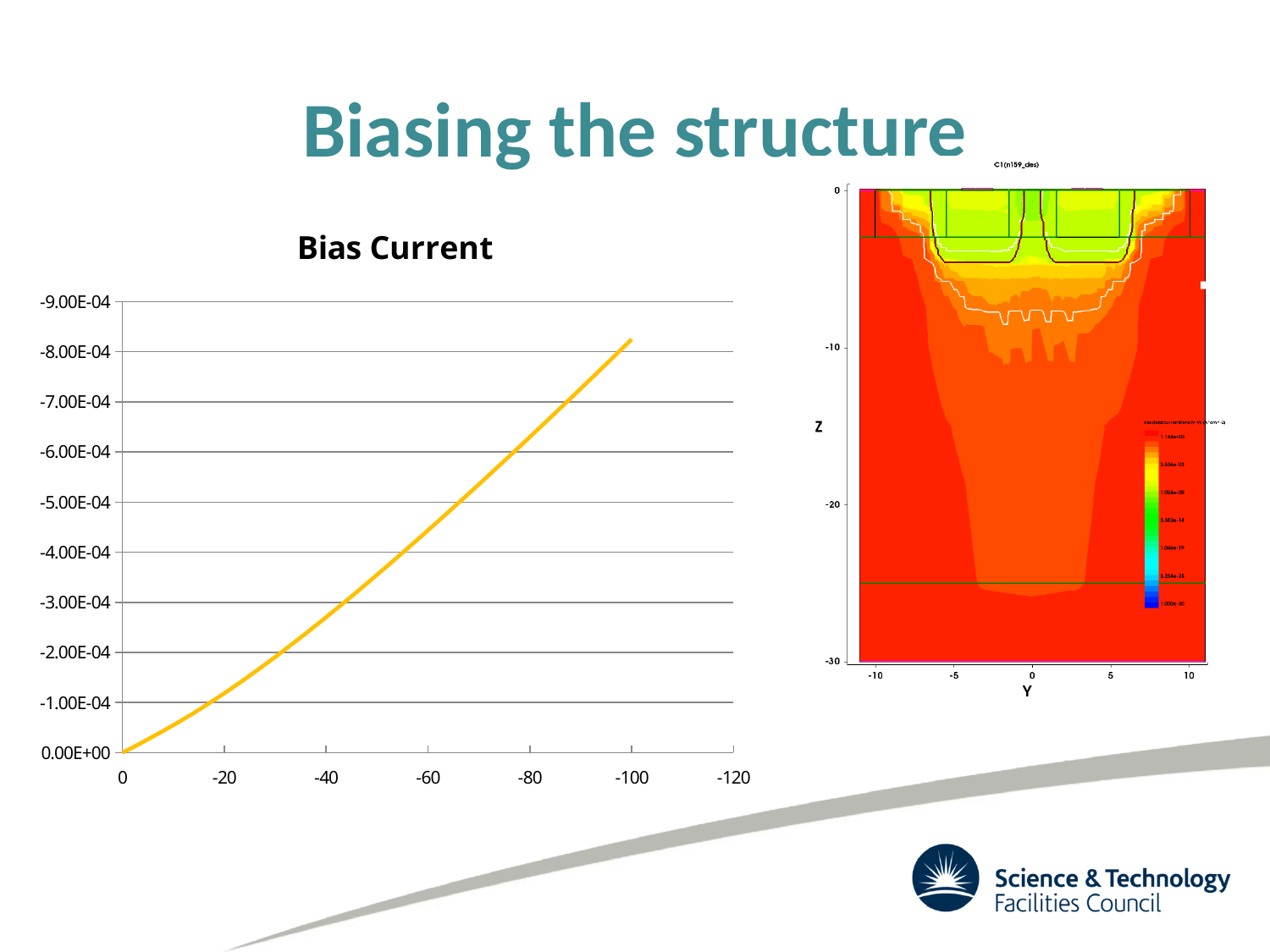
In the 'Bias Current' chart, does the magnitude of the plotted current rise or fall as the x-axis value goes from 0 to -100? rises What is the title of the chart on the left of the slide? Bias Current In the 'Bias Current' chart, at x = -100, is the plotted current magnitude greater or less than 7.00E-04? greater What kind of chart is the 'Bias Current' chart on the left of the slide? line chart In the 'Bias Current' chart, how many lines (series) are plotted? 1 In the 'Bias Current' chart, at x = -40, is the plotted current magnitude greater or less than 3.00E-04? less In the 'Bias Current' chart, how many tick labels are shown on the x axis? 7 In the 'Bias Current' chart, at x = -80, is the plotted current magnitude greater or less than 5.00E-04? greater In the 'Bias Current' chart, which x value has the larger plotted current magnitude, -40 or -80? -80 In the 'Bias Current' chart, what is the plotted value at x = 0? 0.00E+00 In the 'Bias Current' chart, at which x value is the plotted current magnitude lowest? 0 In the 'Bias Current' chart, what is the last (outermost) tick label on the x axis? -120